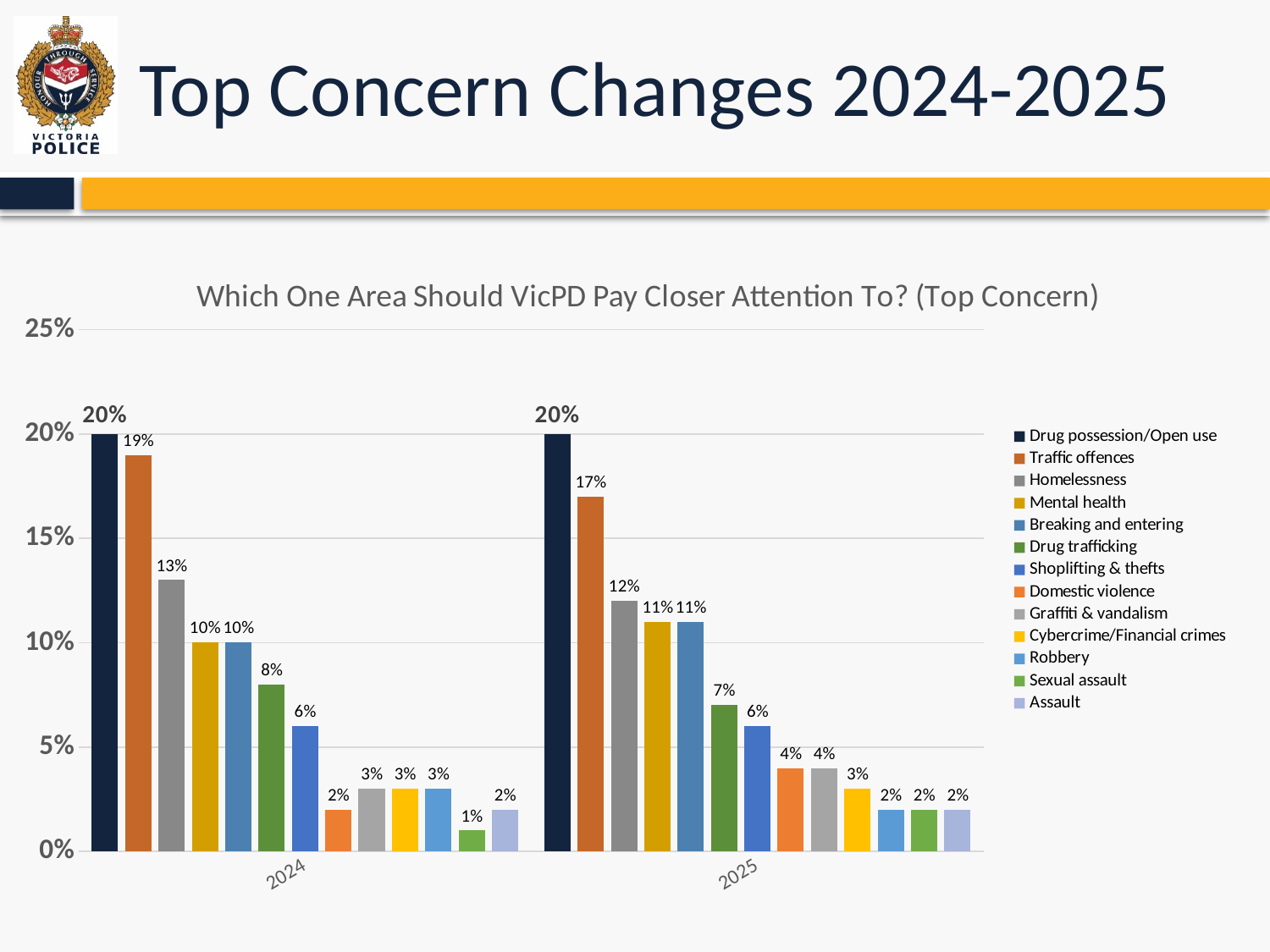
How many year categories are shown on the x axis? 2 What is the value for Domestic violence in 2025? 4% Which is larger, Mental health in 2024 or Mental health in 2025? Mental health in 2025 Which series has the highest value in 2025? Drug possession/Open use What is the value for Homelessness in 2025? 12% What is the difference between the Traffic offences values for 2024 and 2025? 2% What is the value for Traffic offences in 2024? 19% What kind of chart is shown on the slide? Bar chart How many series does the legend list? 13 Which series has the lowest value in 2024? Sexual assault What is the value for Drug trafficking in 2024? 8% What is the title of the chart? Which One Area Should VicPD Pay Closer Attention To? (Top Concern)